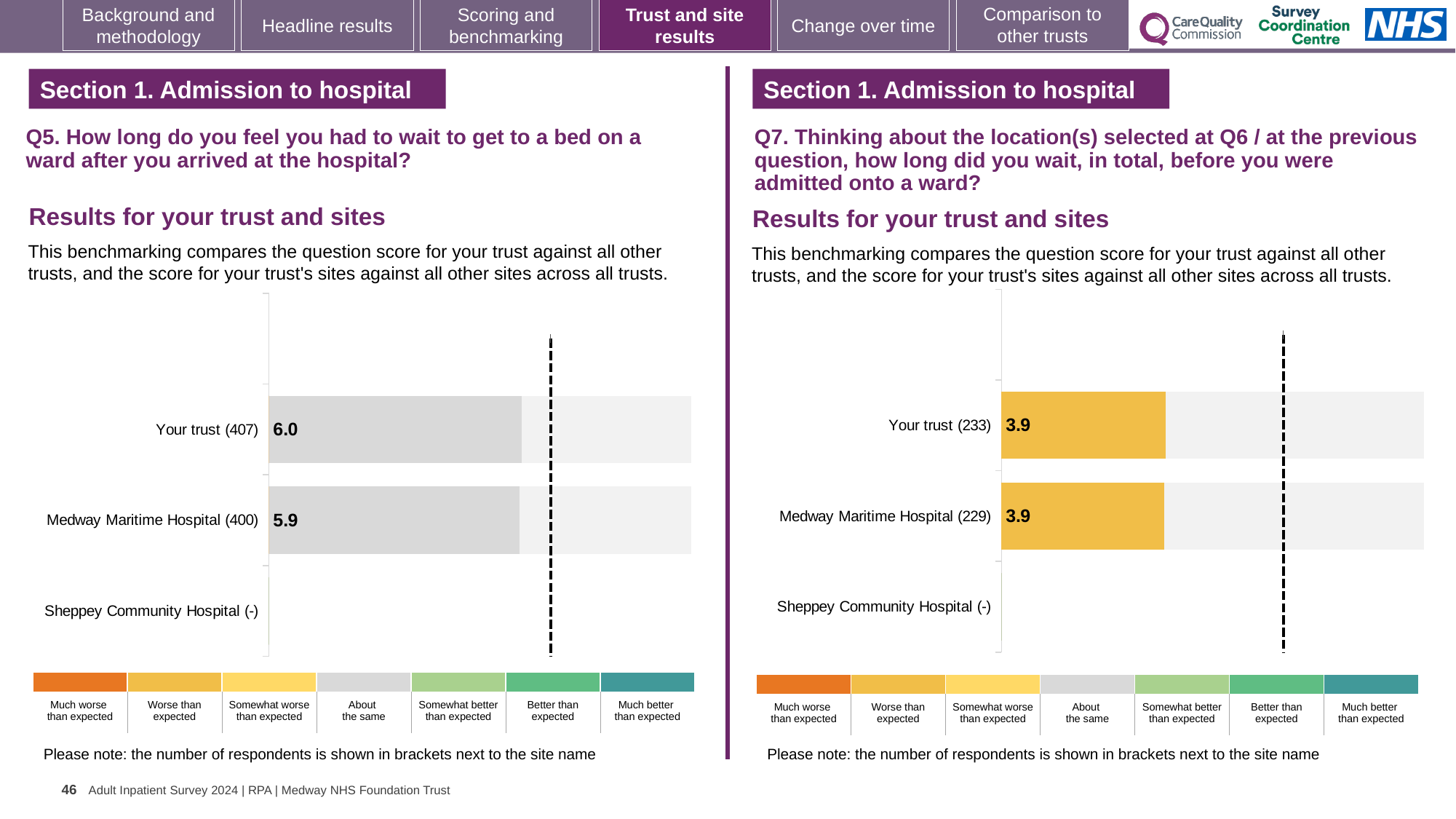
In the Q5 chart on the left, is the score for Your trust greater or less than the score for Medway Maritime Hospital? greater In the Q7 chart on the right, what colour are the bars for Your trust and Medway Maritime Hospital? Yellow In the Q7 chart on the right, what is the score for Medway Maritime Hospital? 3.9 In the Q7 chart on the right, how many categories (sites) are listed on the vertical axis? 3 In the Q7 chart on the right, how many respondents are shown in brackets for Medway Maritime Hospital? 229 In the Q5 chart on the left, what is the score for Your trust? 6.0 In the Q7 chart on the right, what is the score for Your trust? 3.9 In the Q5 chart on the left, how many respondents are shown in brackets for Your trust? 407 What kind of chart is the Q5 chart on the left? Bar chart In the Q5 chart on the left, which site has no score shown? Sheppey Community Hospital In the Q5 chart on the left, what is the score for Medway Maritime Hospital? 5.9 In the Q5 chart on the left, what is the difference between the score for Your trust and the score for Medway Maritime Hospital? 0.1